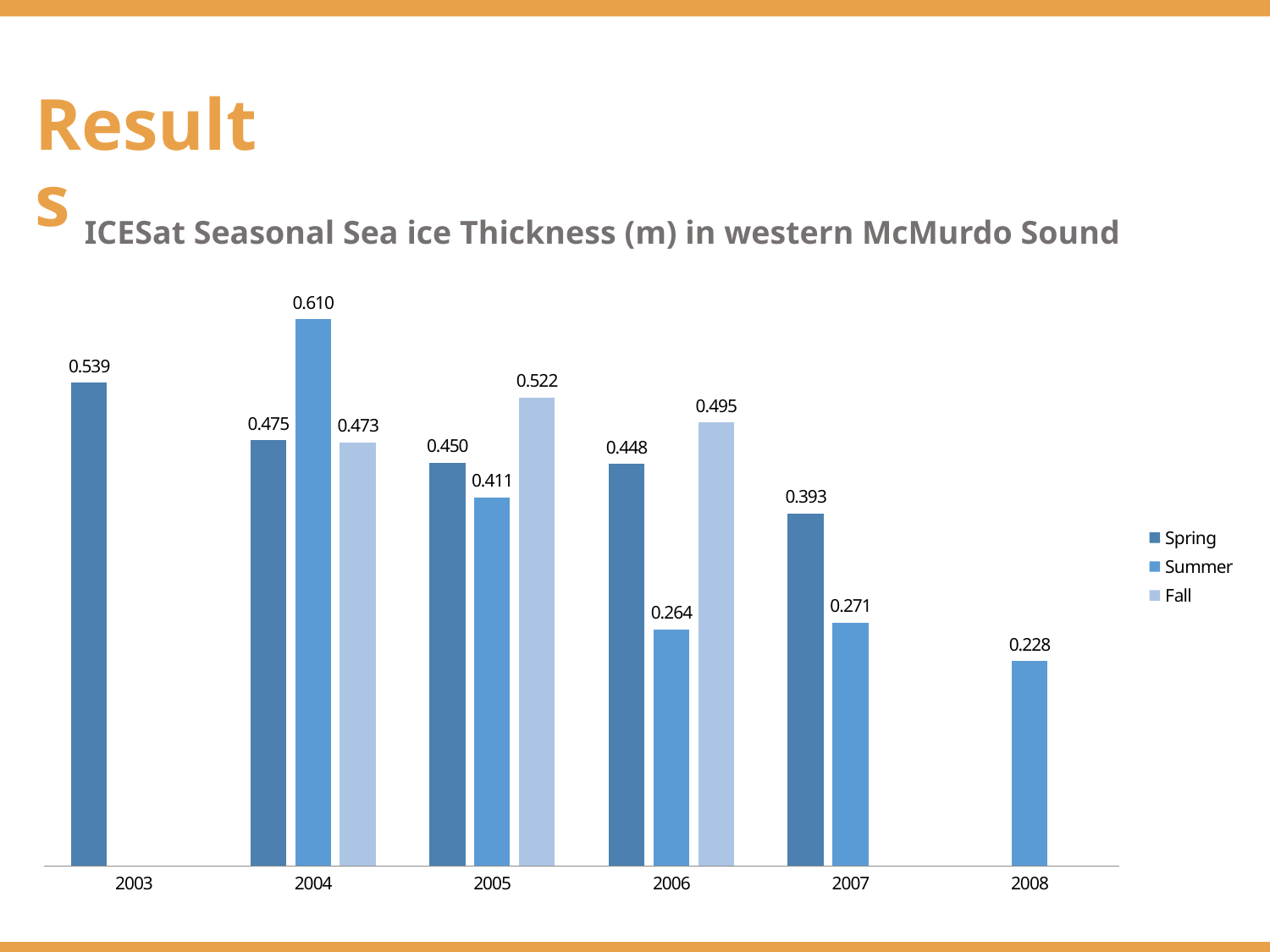
Which is larger, the Summer value for 2005 or the Summer value for 2006? 2005 What is the Fall sea ice thickness for 2006? 0.495 What is the Summer sea ice thickness for 2008? 0.228 What kind of chart is shown on the slide? Bar chart How many series does the legend list? 3 What is the Summer sea ice thickness for 2004? 0.610 Which year has the highest Spring sea ice thickness? 2003 How many years are shown on the x axis? 6 Which year has the lowest Summer sea ice thickness? 2008 Does the Spring sea ice thickness rise or fall from 2003 to 2007? Fall What is the difference between the Fall values for 2005 and 2006? 0.027 What is the Spring sea ice thickness for 2003? 0.539